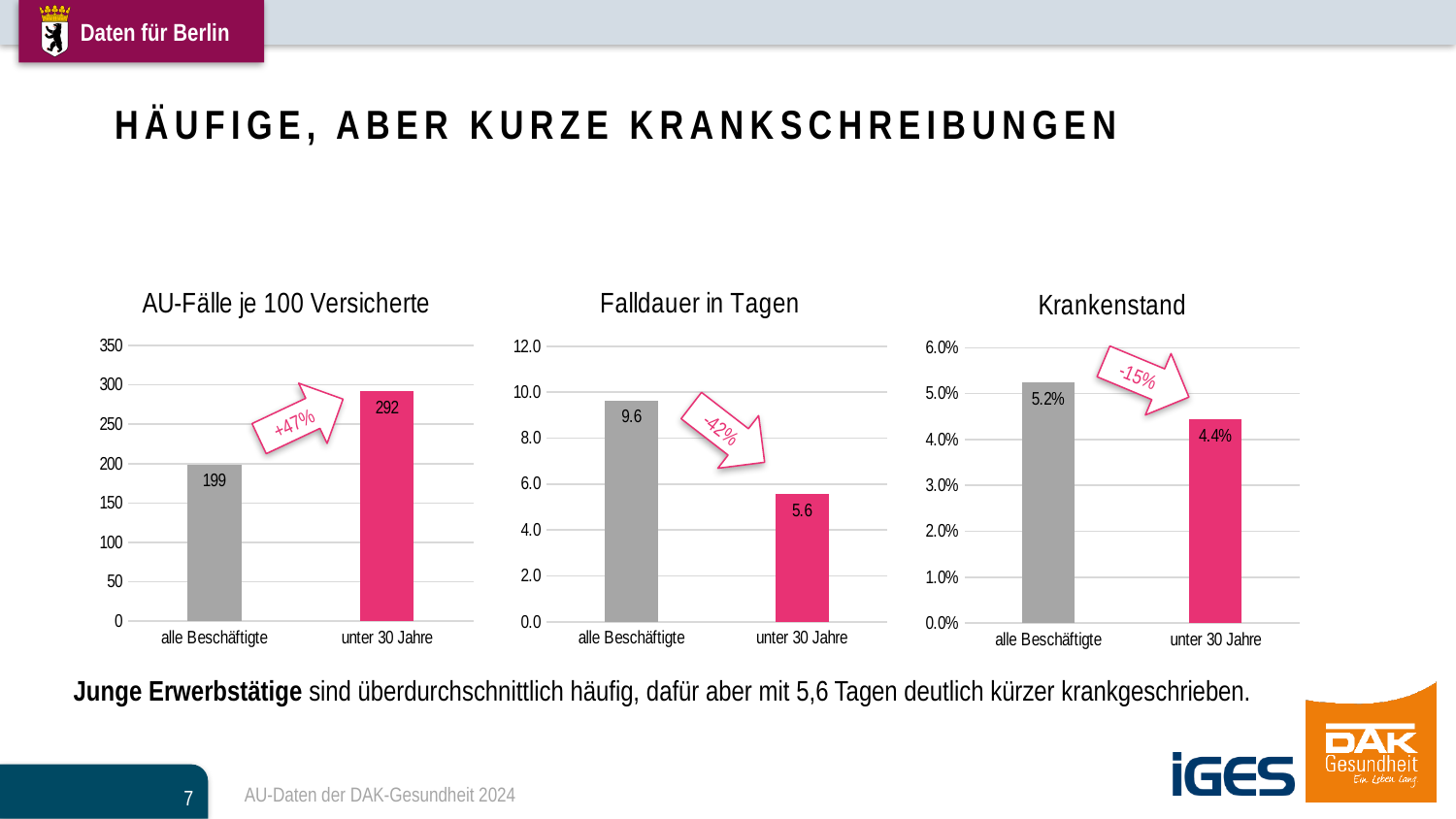
In the 'AU-Fälle je 100 Versicherte' chart, what is the value for 'alle Beschäftigte'? 199 In the 'Falldauer in Tagen' chart, what is the value for 'alle Beschäftigte'? 9.6 In the 'AU-Fälle je 100 Versicherte' chart, is the value for 'unter 30 Jahre' greater or less than 250? greater How many categories does the 'Falldauer in Tagen' chart show? 2 In the 'Krankenstand' chart, which category has the higher value? alle Beschäftigte In the 'Falldauer in Tagen' chart, what is the value for 'unter 30 Jahre'? 5.6 In the 'AU-Fälle je 100 Versicherte' chart, what is the value for 'unter 30 Jahre'? 292 In the 'Krankenstand' chart, what is the value for 'unter 30 Jahre'? 4.4% In the 'AU-Fälle je 100 Versicherte' chart, what is the difference between 'unter 30 Jahre' and 'alle Beschäftigte'? 93 In the 'Krankenstand' chart, what is the value for 'alle Beschäftigte'? 5.2% In the 'Falldauer in Tagen' chart, which category has the lower value? unter 30 Jahre What kind of chart is the 'Krankenstand' chart? bar chart